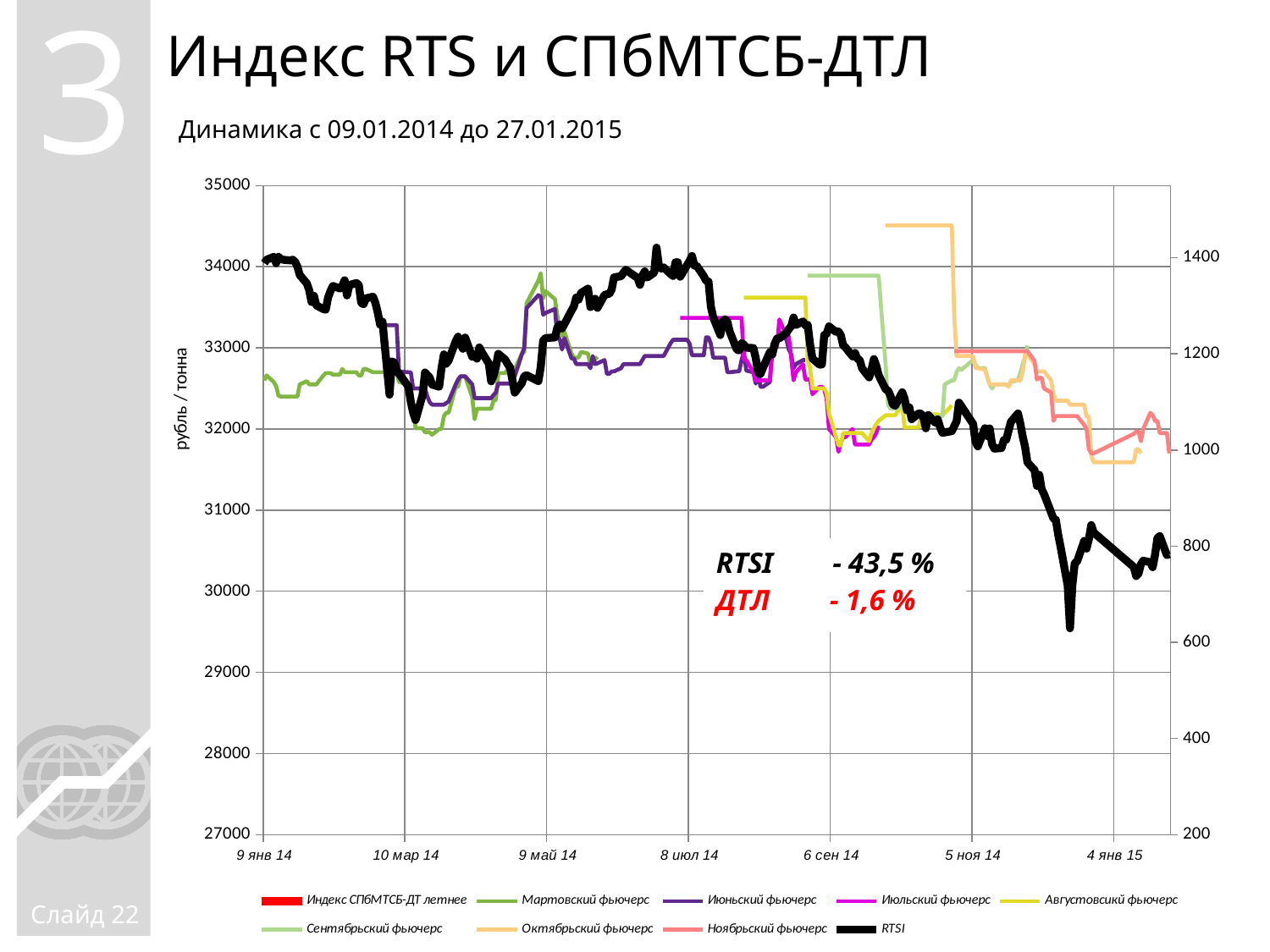
What is the label of the left vertical axis? рубль / тонна Is the highest value of Октябрьский фьючерс greater or less than 34000? greater Is the value of RTSI (right axis) at the start of the period greater or less than 1200? greater How many series does the legend list? 9 Is the lowest value of RTSI (right axis) greater or less than 800? less Does the RTSI line rise or fall overall from January 2014 to January 2015? fall How many date labels are shown on the x axis? 7 What kind of chart is shown on the slide? line chart Which fell more in percentage terms over the period, RTSI or ДТЛ? RTSI What percentage change is shown for RTSI on the chart? - 43,5 % What percentage change is shown for ДТЛ on the chart? - 1,6 % What is the title of the chart slide? Индекс RTS и СПбМТСБ-ДТЛ